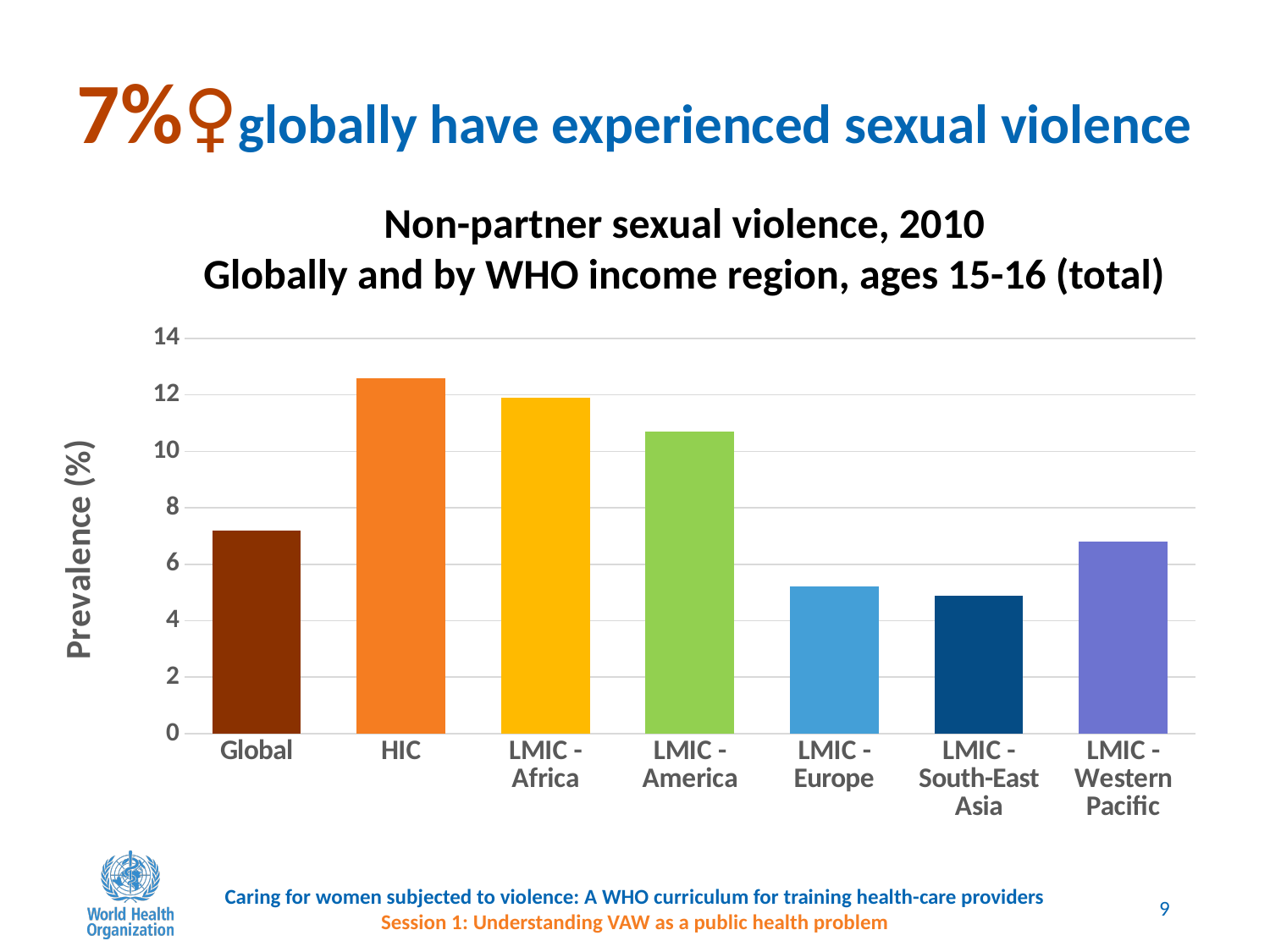
How many categories are shown on the x axis of the chart? 7 What kind of chart is shown on the slide? bar chart Is the value for LMIC - Western Pacific greater or less than 6? greater Which is larger, the value for LMIC - America or the value for LMIC - Europe? LMIC - America Is the value for LMIC - Europe greater or less than 6? less Is the value for Global greater or less than 8? less Which category has the highest prevalence in the chart? HIC What is the label of the vertical axis of the chart? Prevalence (%)